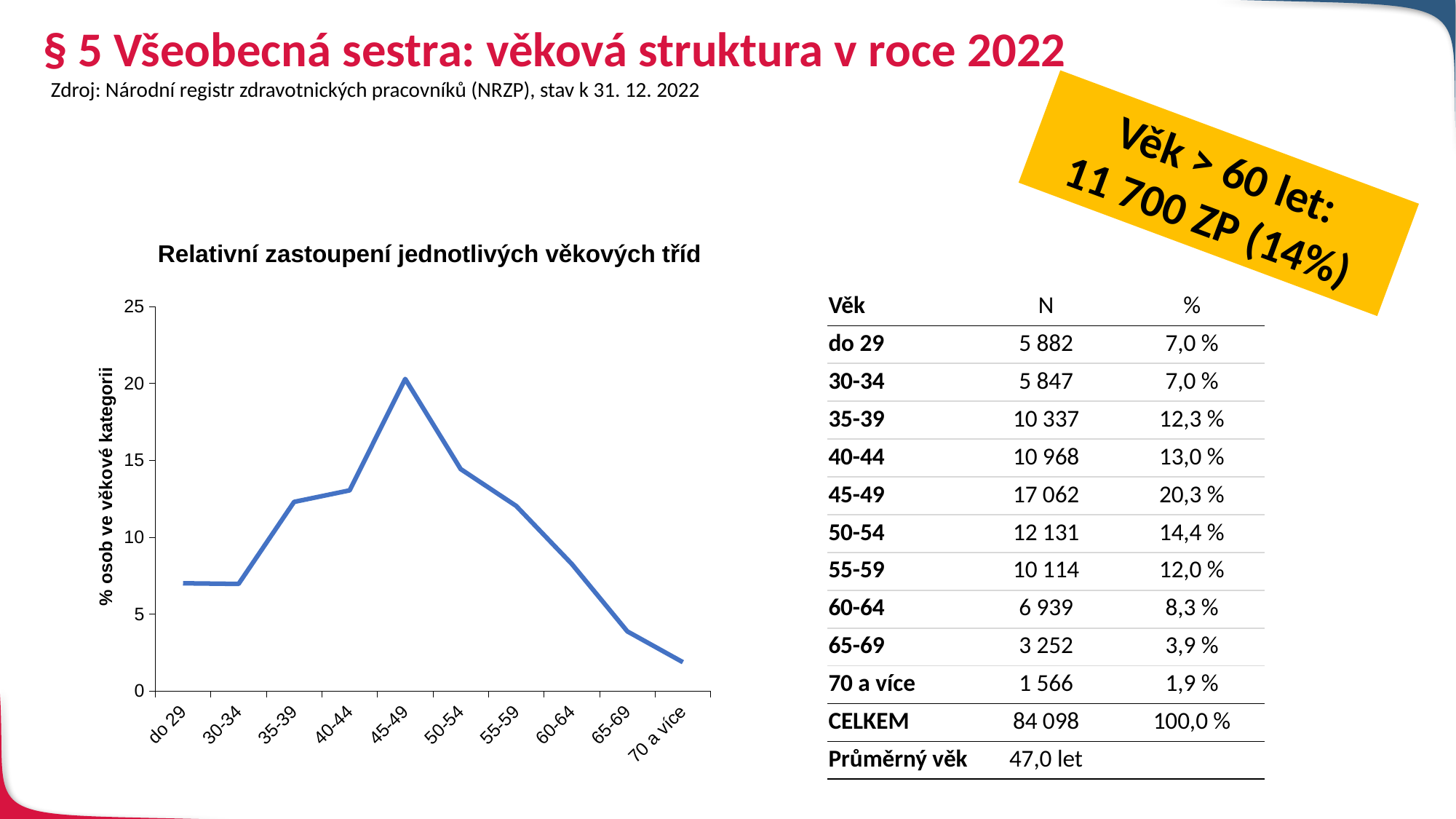
Which has a larger value in the chart, 40-44 or 60-64? 40-44 What is the title of the chart? Relativní zastoupení jednotlivých věkových tříd Is the value for 65-69 greater or less than 5? less Is the value for 45-49 greater or less than 20? greater Is the value for 50-54 greater or less than 15? less What is the label of the y axis of the chart? % osob ve věkové kategorii Which age category has the highest value in the chart? 45-49 According to the table accompanying the chart, what percentage share does the 45-49 age category have? 20,3 % Which age category has the lowest value in the chart? 70 a více How many age categories are plotted along the x axis of the chart? 10 Do the values rise or fall along the x axis from 45-49 to 70 a více? fall What kind of chart is shown on the slide? line chart